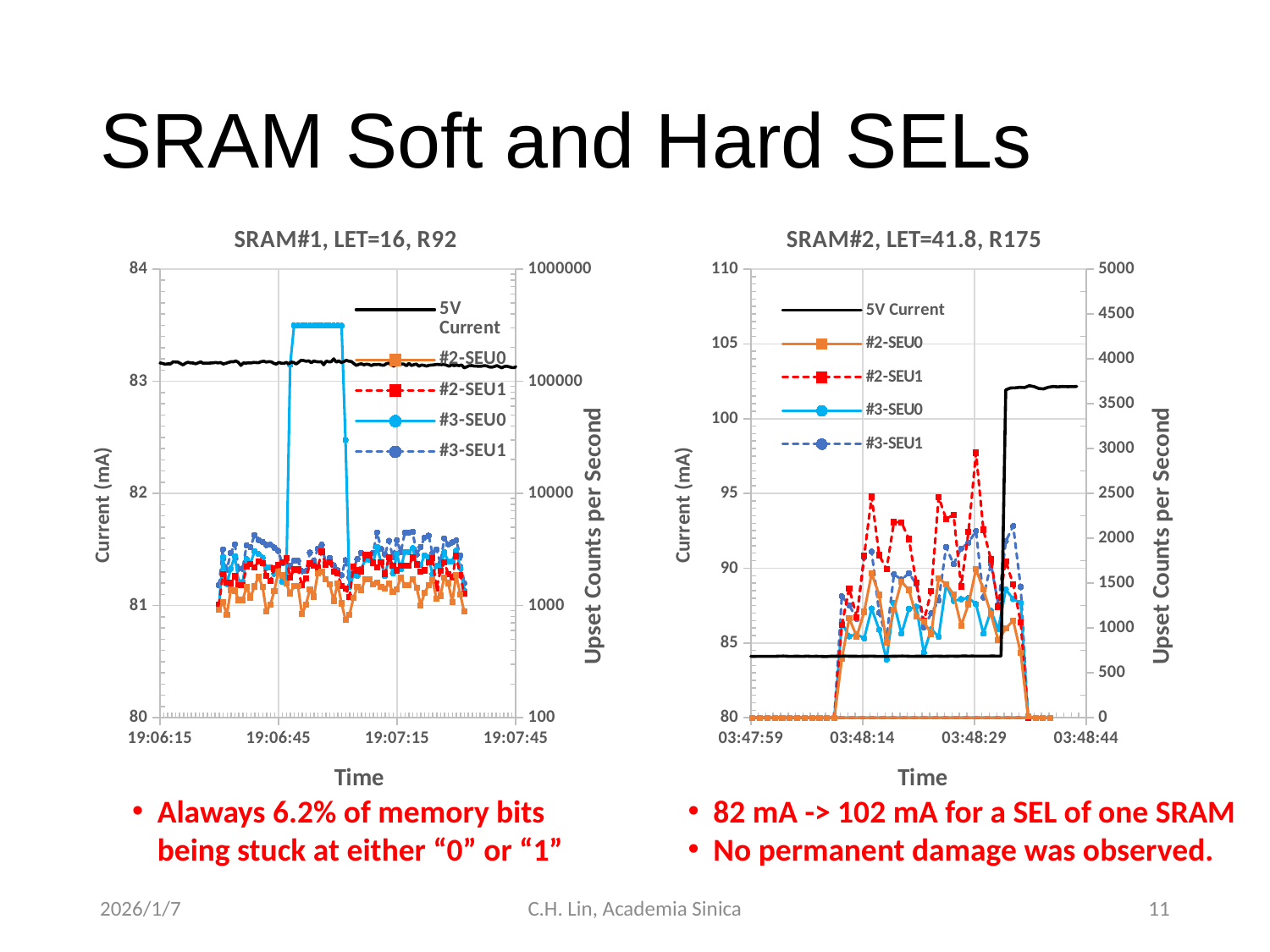
In the SRAM#2, LET=41.8, R175 chart, is the 5V Current at 03:48:44 greater or less than the 5V Current at 03:47:59? greater In the SRAM#1, LET=16, R92 chart, is the peak of the #3-SEU0 series greater or less than 100000 upset counts per second? greater In the SRAM#2, LET=41.8, R175 chart, does the 5V Current rise or fall over time? rise How many series does the legend of the SRAM#2, LET=41.8, R175 chart list? 5 In the SRAM#1, LET=16, R92 chart, is the 5V Current at 19:06:15 greater or less than 84 mA? less What is the title of the chart on the left of the slide? SRAM#1, LET=16, R92 In the SRAM#2, LET=41.8, R175 chart, which series reaches the highest upset counts per second? #2-SEU1 In the SRAM#2, LET=41.8, R175 chart, is the 5V Current at 03:47:59 greater or less than 90 mA? less What is the label of the right-hand vertical axis in the SRAM#2, LET=41.8, R175 chart? Upset Counts per Second What kind of chart is the SRAM#1, LET=16, R92 chart? line chart How many charts are shown on the slide? 2